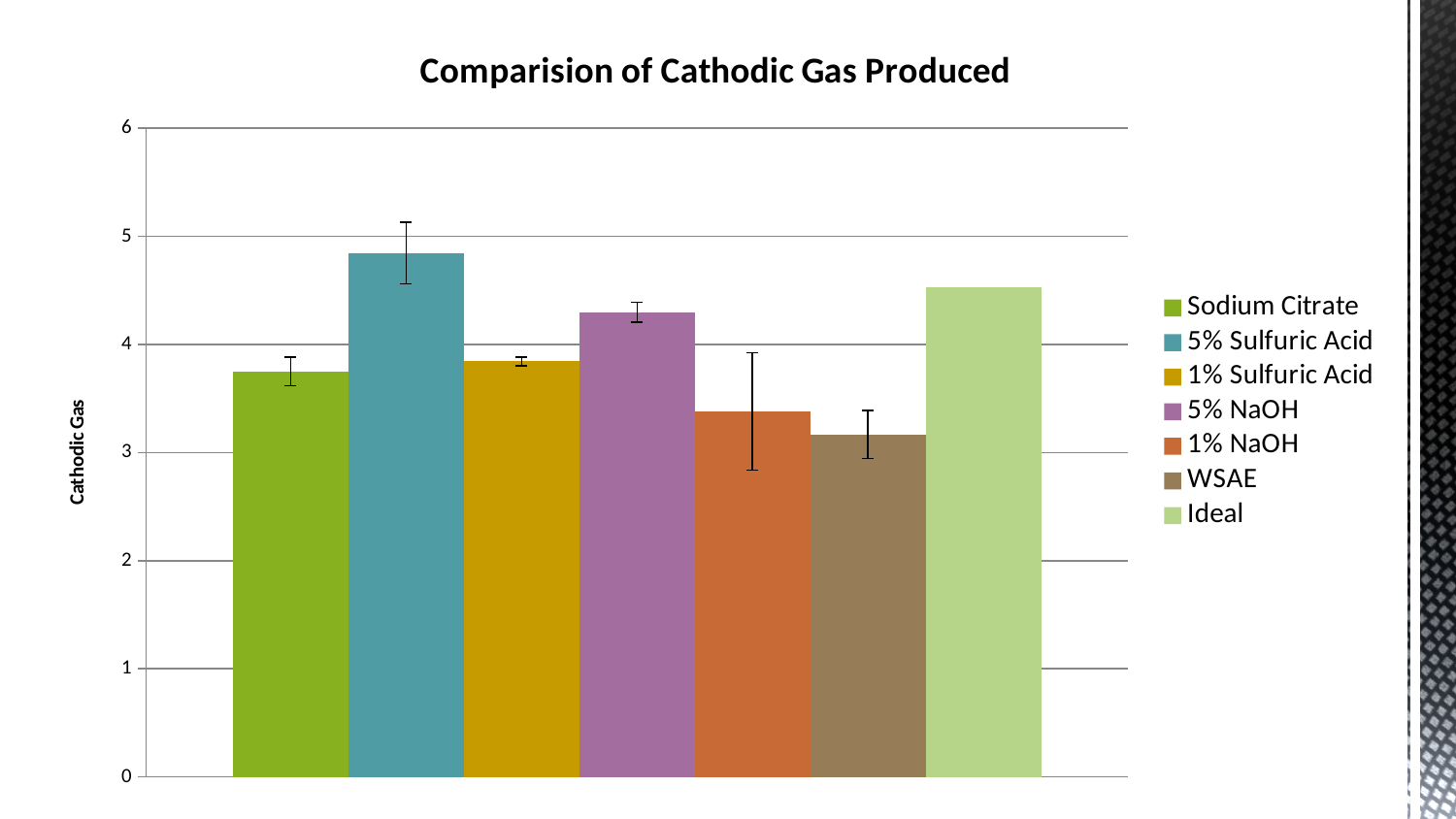
Which category has the lowest cathodic gas value? WSAE Which category has the highest cathodic gas value? 5% Sulfuric Acid What kind of chart is shown on the slide? bar chart How many entries does the legend list? 7 How many bars are plotted in the chart? 7 Is the value for WSAE greater or less than 3? greater Is the value for Ideal greater or less than 4? greater Is the value for 5% Sulfuric Acid greater or less than 5? less Which is larger, the value for 5% NaOH or the value for 1% NaOH? 5% NaOH Which is larger, the value for 5% Sulfuric Acid or the value for Ideal? 5% Sulfuric Acid What is the title of the chart? Comparision of Cathodic Gas Produced